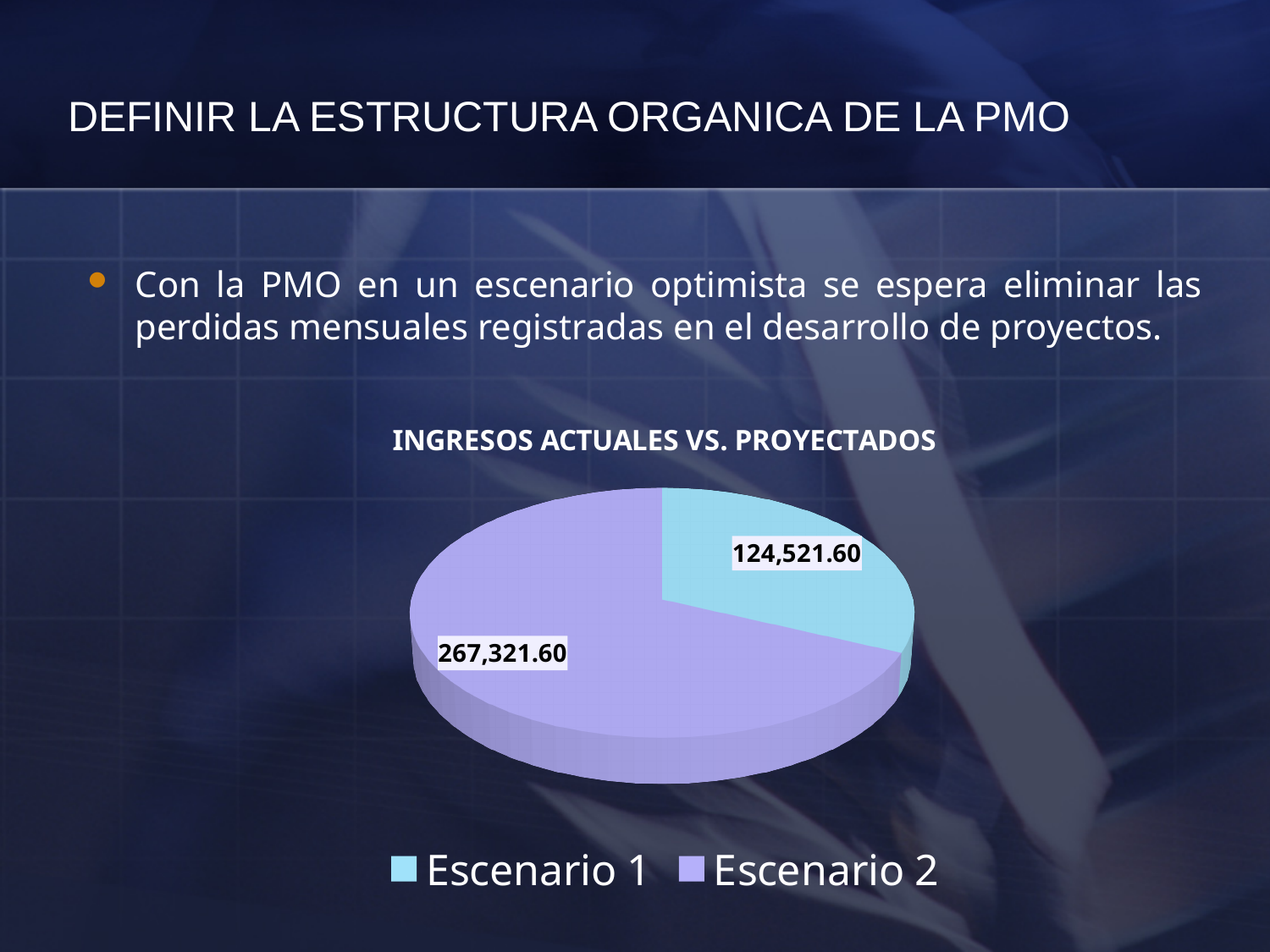
Which is larger, the value for Escenario 1 or Escenario 2? Escenario 2 What share of the pie does Escenario 2 represent? 68.2% Which colour represents Escenario 1 in the legend? light blue What is the value for Escenario 1? 124,521.60 What is the total of the two slices in the pie? 391,843.20 How many slices does the pie chart have? 2 What is the title of the chart? INGRESOS ACTUALES VS. PROYECTADOS Which scenario has the largest slice of the pie? Escenario 2 Which scenario has the smallest slice of the pie? Escenario 1 What type of chart is shown on the slide? pie chart What is the difference between the values for Escenario 2 and Escenario 1? 142,800.00 What is the value for Escenario 2? 267,321.60